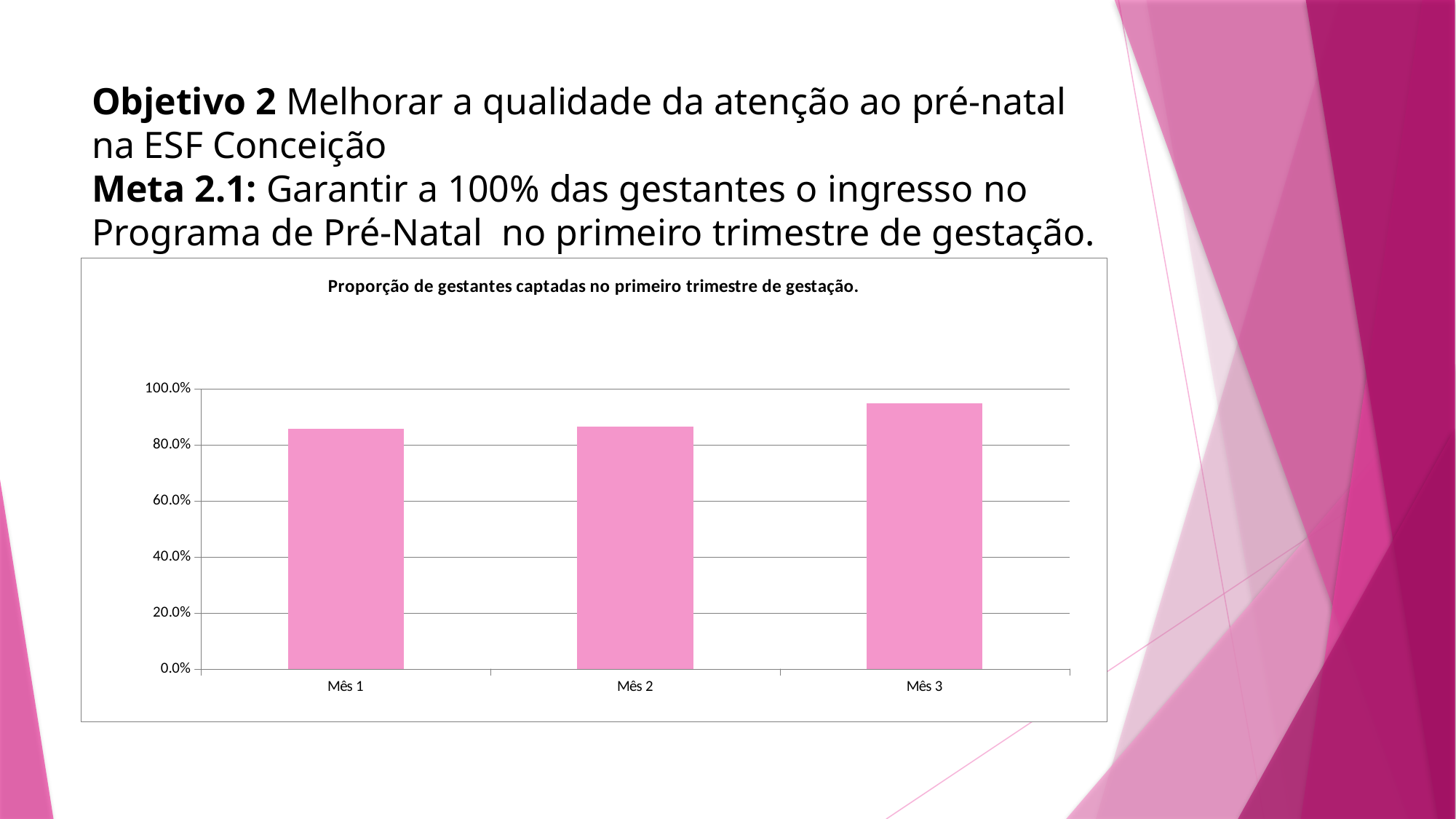
Is the value for Mês 3 greater or less than 80.0%? greater Is the value for Mês 1 greater or less than 100.0%? less Is the value for Mês 3 greater or less than 100.0%? less What is the title of the chart? Proporção de gestantes captadas no primeiro trimestre de gestação. Do the values rise or fall from Mês 1 to Mês 3? rise What is the highest value shown on the vertical axis? 100.0% Which is larger, the value for Mês 3 or the value for Mês 1? Mês 3 What kind of chart is shown on the slide? bar chart How many categories (months) are plotted on the chart? 3 Which month has the highest proportion of pregnant women captured in the first trimester? Mês 3